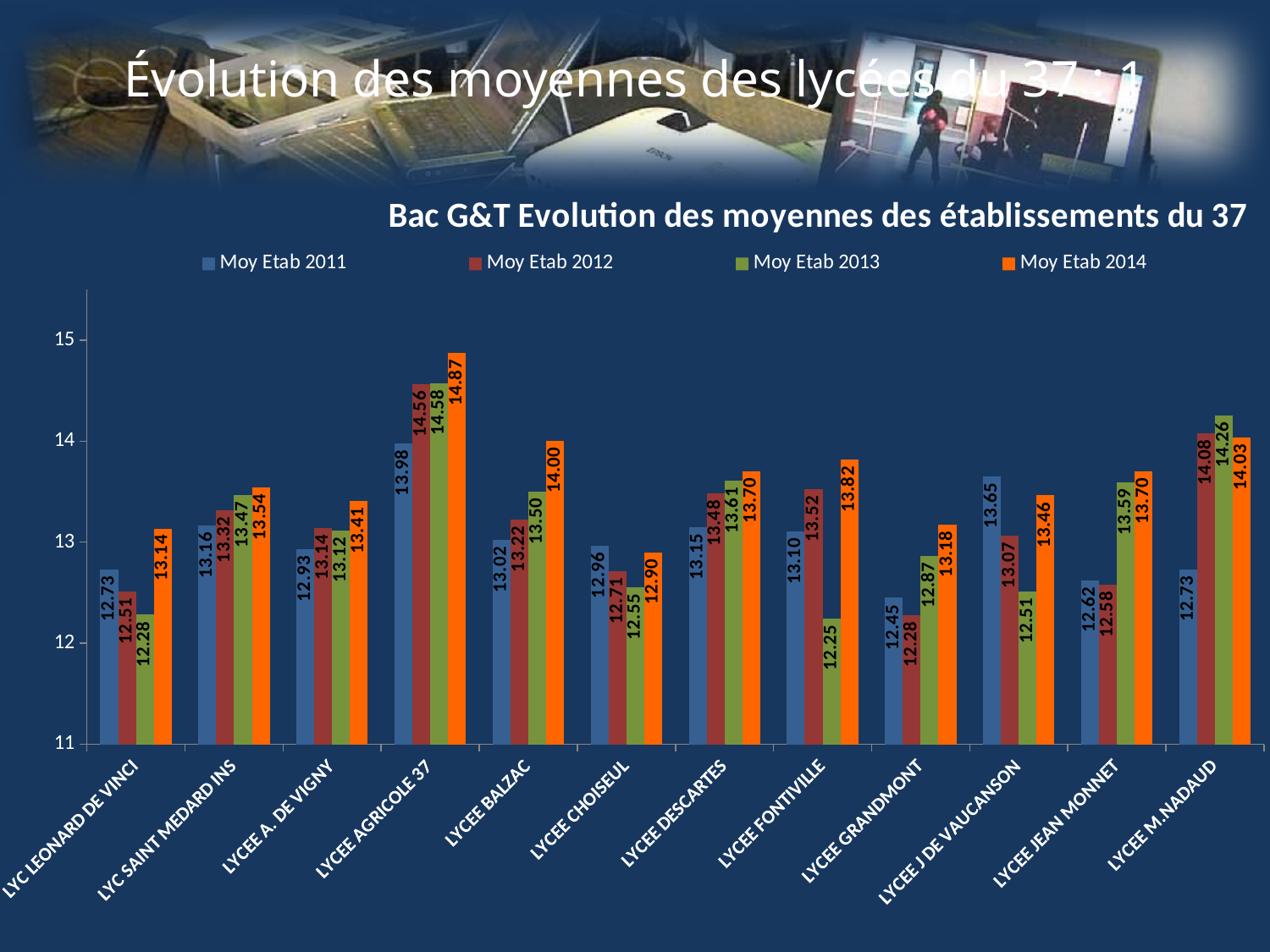
How many series does the legend list? 4 How many establishments are shown on the x axis? 12 What kind of chart is shown on the slide? Bar chart Which establishment has the highest Moy Etab 2014 value? LYCEE AGRICOLE 37 What is the Moy Etab 2013 value for LYCEE FONTIVILLE? 12.25 Which is larger for LYCEE CHOISEUL: the Moy Etab 2011 value or the Moy Etab 2014 value? Moy Etab 2011 What is the difference between the Moy Etab 2014 and Moy Etab 2011 values for LYCEE BALZAC? 0.98 Which establishment has the lowest Moy Etab 2013 value? LYCEE FONTIVILLE Do the values for LYC SAINT MEDARD INS rise or fall from Moy Etab 2011 to Moy Etab 2014? Rise Is the Moy Etab 2012 value for LYCEE M.NADAUD greater or less than 14? greater What is the Moy Etab 2014 value for LYCEE AGRICOLE 37? 14.87 What is the Moy Etab 2011 value for LYCEE J DE VAUCANSON? 13.65